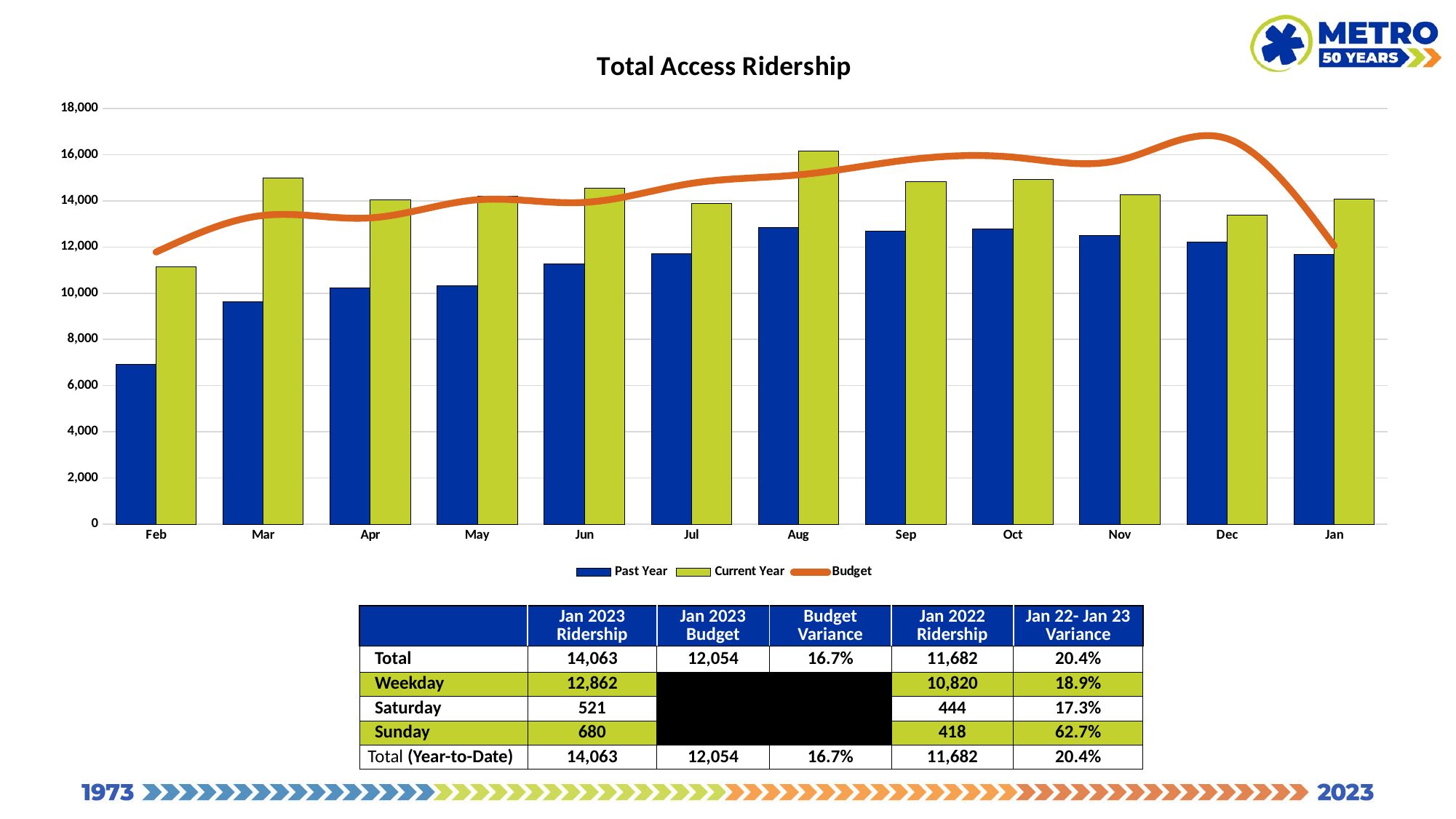
Is the Past Year value for Feb greater or less than 8,000? less What is the Past Year (Jan 2022) ridership for Jan, as given in the table? 11,682 What is the difference between the Jan 2023 ridership and the Jan 2023 budget? 2,009 What is the Current Year ridership for Jan, as given in the table? 14,063 How many series does the legend list? 3 Which month has the highest Current Year bar? Aug Which month has the lowest Past Year bar? Feb Is the Current Year value for Mar greater or less than 14,000? greater In Feb, which is larger: the Past Year bar or the Current Year bar? Current Year What kind of chart is shown on the slide? bar chart with a line How many months are shown on the x axis? 12 In which month does the Budget line reach its highest point? Dec